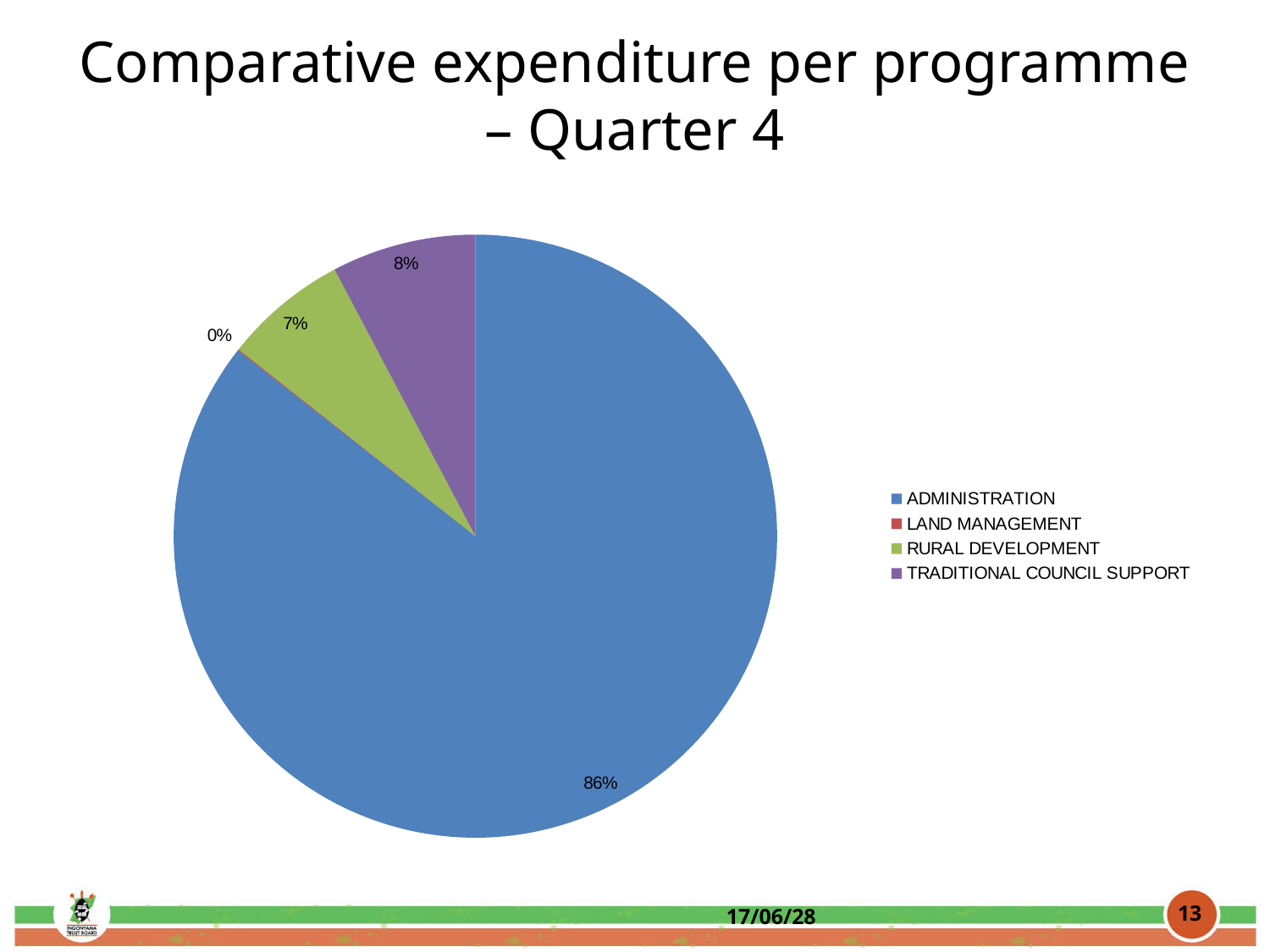
What is the title of the chart slide? Comparative expenditure per programme – Quarter 4 What kind of chart is shown on the slide? pie chart Which colour represents RURAL DEVELOPMENT in the pie chart? green What share of expenditure does RURAL DEVELOPMENT account for? 7% What share of expenditure does LAND MANAGEMENT account for? 0% What is the difference in percentage points between the ADMINISTRATION share and the TRADITIONAL COUNCIL SUPPORT share? 78 What share of expenditure does TRADITIONAL COUNCIL SUPPORT account for? 8% Which programme has the smallest share of expenditure? LAND MANAGEMENT How many programmes are listed in the legend? 4 Which programme has the largest share of expenditure? ADMINISTRATION Which has a larger share, RURAL DEVELOPMENT or TRADITIONAL COUNCIL SUPPORT? TRADITIONAL COUNCIL SUPPORT